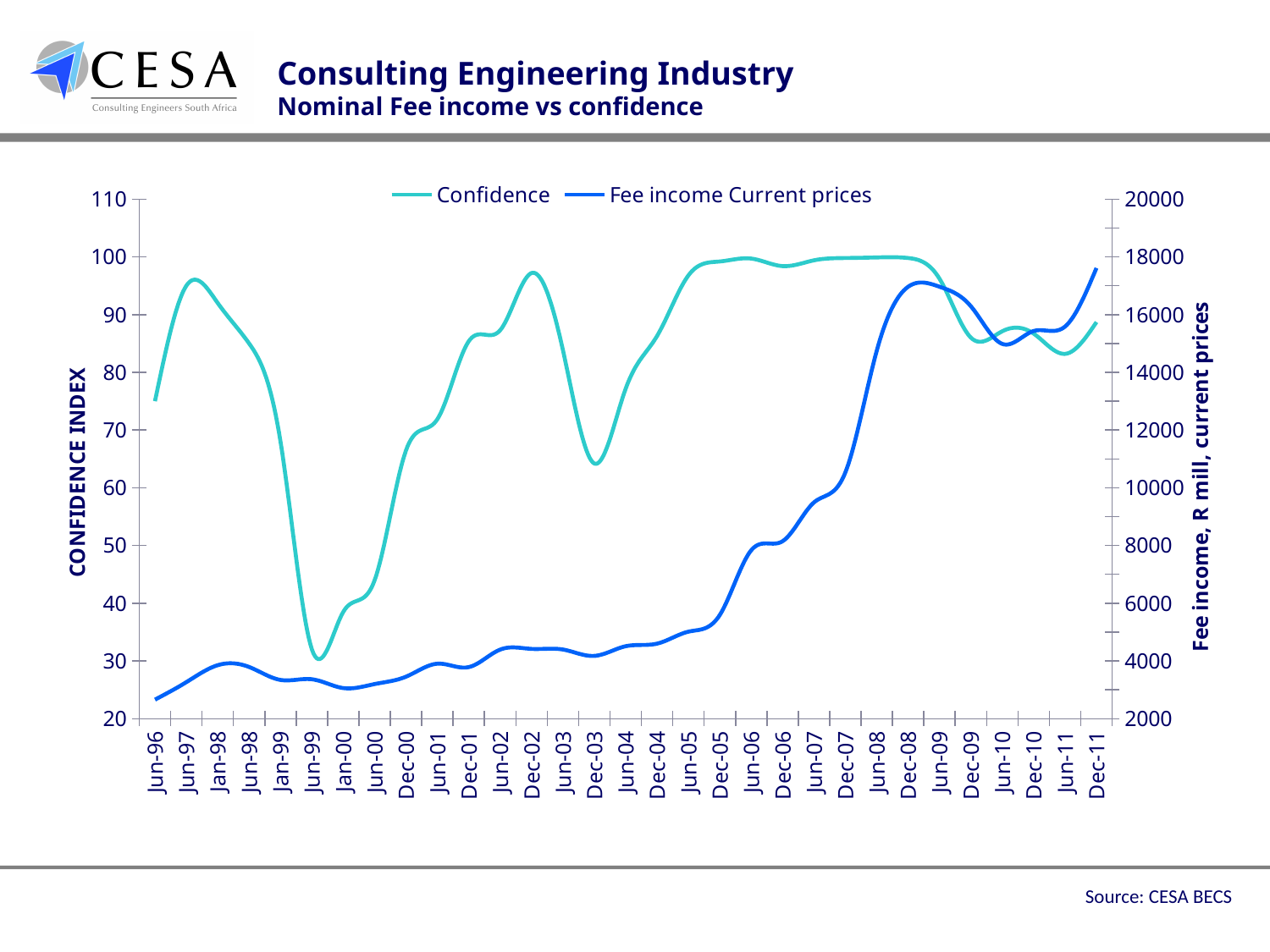
What kind of chart is shown on the slide? Line chart Is the Confidence value at Jun-99 greater or less than 40? less How many series does the legend list? 2 Around which x-axis label does the Confidence series reach its lowest point? Jun-99 Is the Fee income Current prices value at Dec-11 greater or less than 16000? greater Is the Confidence value at Dec-02 greater or less than 90? greater Does the Fee income Current prices series overall rise or fall from Jun-96 to Dec-11? Rise What is the label on the right-hand vertical axis? Fee income, R mill, current prices What is the subtitle of the chart slide? Nominal Fee income vs confidence